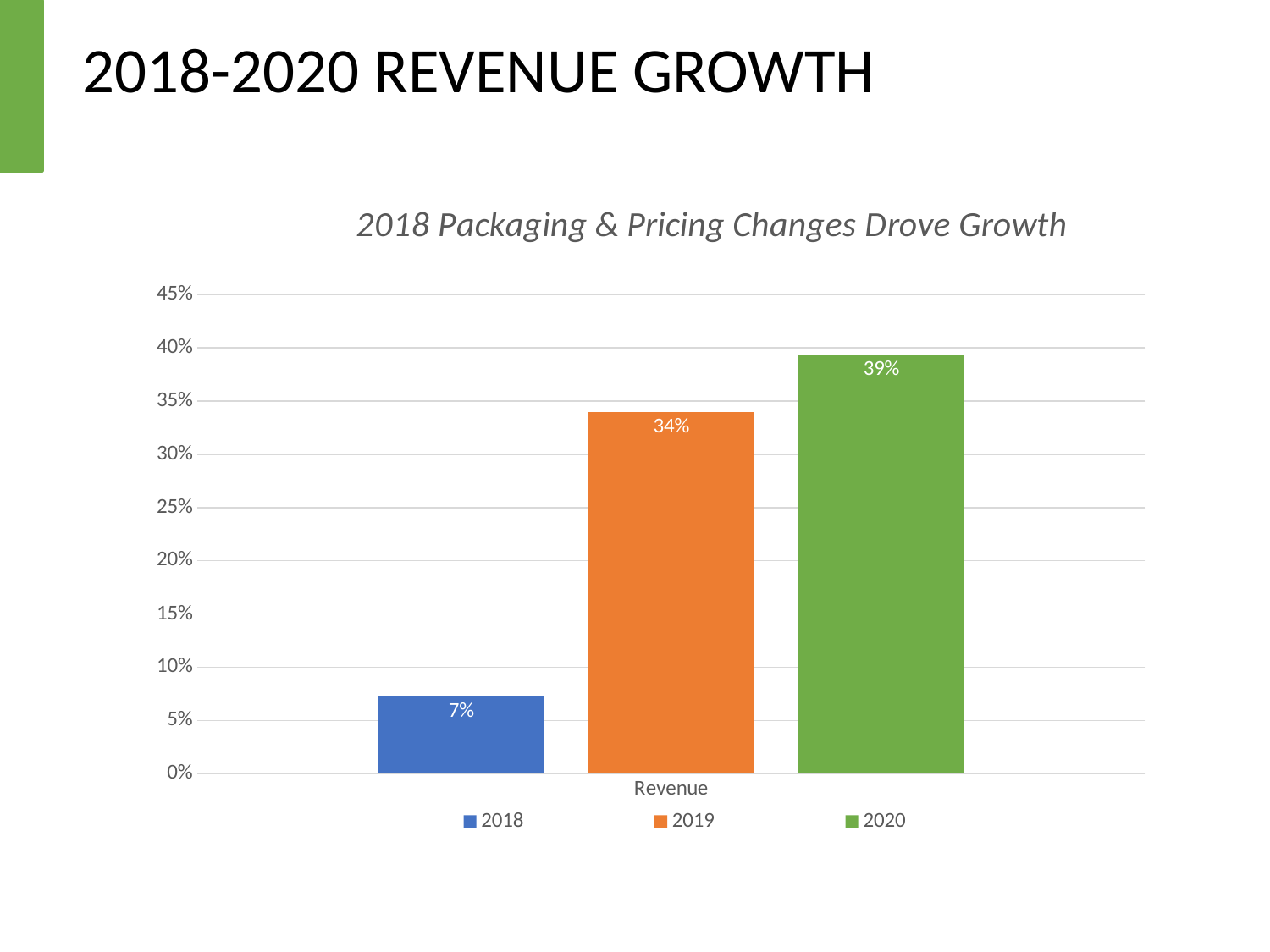
What is the title of the chart? 2018 Packaging & Pricing Changes Drove Growth Which year has the highest revenue growth? 2020 What is the revenue growth value for 2018? 7% Which year has the lowest revenue growth? 2018 Which is larger, the revenue growth for 2018 or for 2019? 2019 What is the difference between the 2020 and 2019 revenue growth values? 5% What is the difference between the 2019 and 2018 revenue growth values? 27% What kind of chart is shown on the slide? Bar chart How many series does the legend list? 3 What is the revenue growth value for 2019? 34% What is the revenue growth value for 2020? 39% Do the revenue growth values rise or fall from 2018 to 2020? Rise